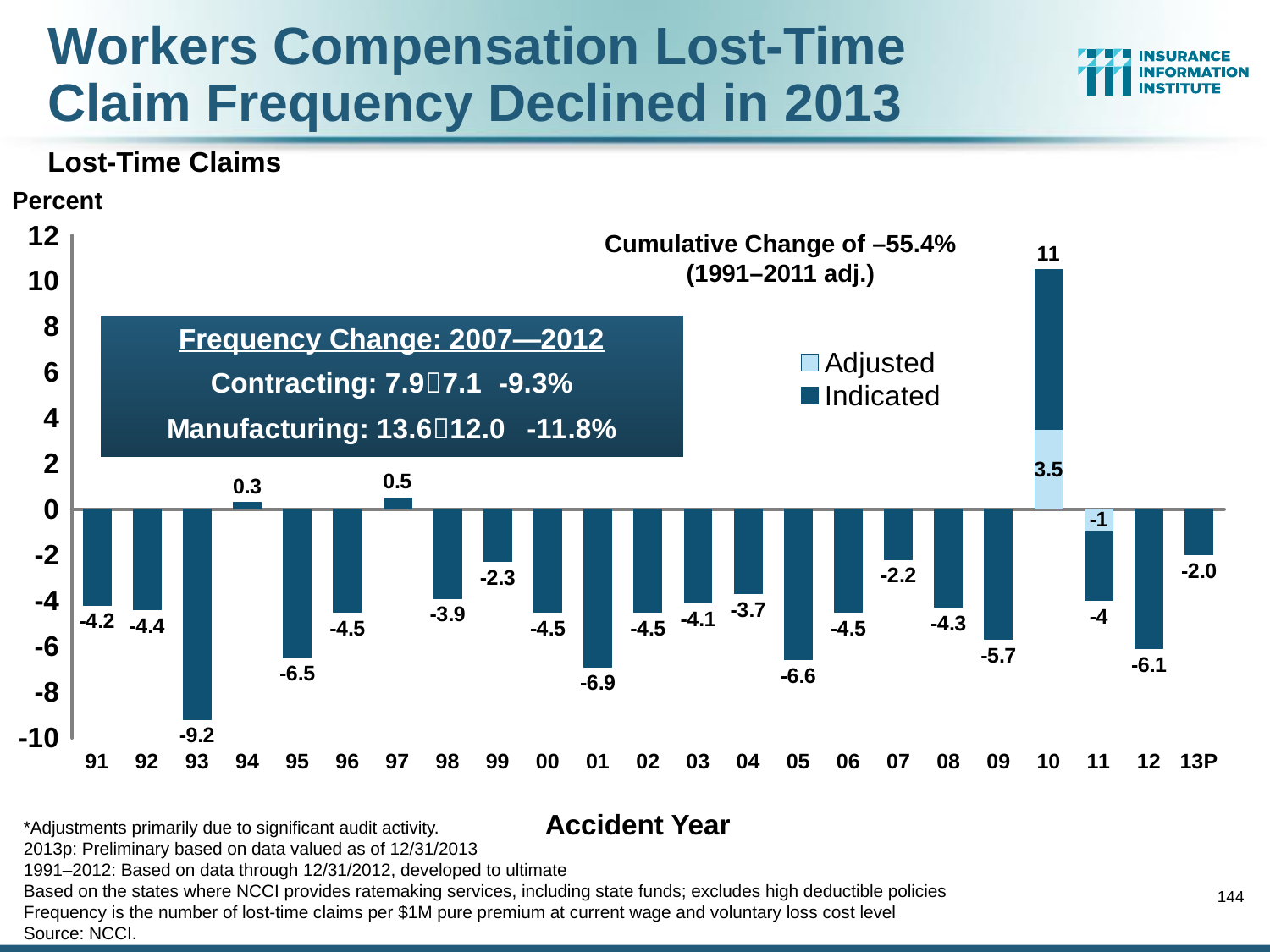
What is the Adjusted value shown for accident year 10? 3.5 How many accident years are shown on the x axis? 23 What is the Indicated value shown for accident year 10? 11 What cumulative change for 1991–2011 (adj.) is stated on the chart? –55.4% How many series does the legend list? 2 Which accident year has a larger value, 01 or 05? 05 What is the value for accident year 93? -9.2 Which accident year has the lowest value? 93 Which accident year has the highest value? 10 What kind of chart is shown on the slide? Bar chart What is the value for accident year 13P? -2.0